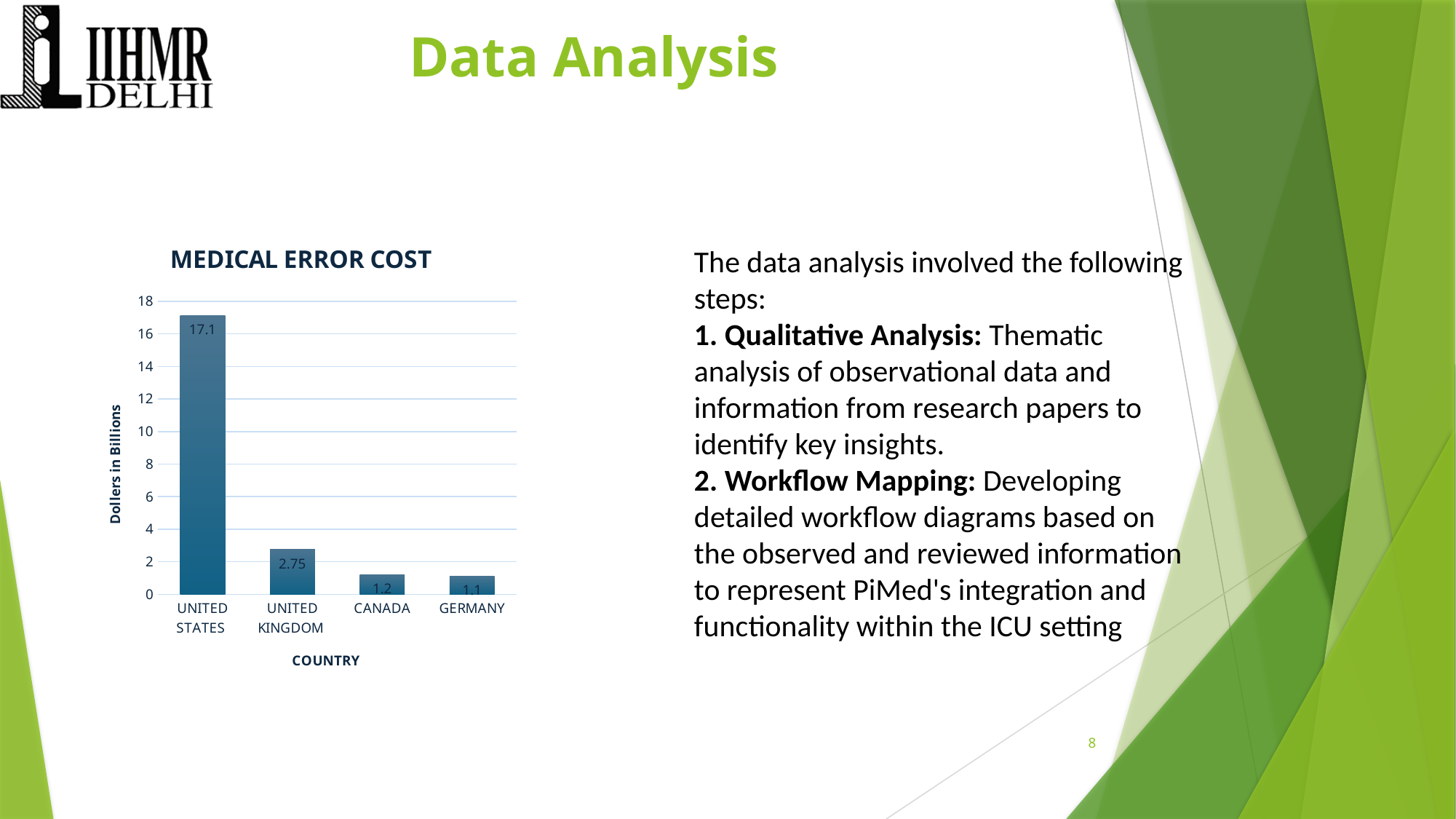
Which country has the lowest medical error cost? Germany Which has a higher medical error cost, the United Kingdom or Canada? United Kingdom What is the medical error cost for Germany? 1.1 What is the medical error cost for the United Kingdom? 2.75 What is the medical error cost for Canada? 1.2 How many countries are shown in the chart? 4 Which country has the highest medical error cost? United States Is the value for the United States greater or less than 16? greater What is the difference between the medical error cost of the United States and the United Kingdom? 14.35 What is the medical error cost for the United States? 17.1 What kind of chart is shown on the slide? Bar chart What is the label of the vertical axis of the chart? Dollers in Billions